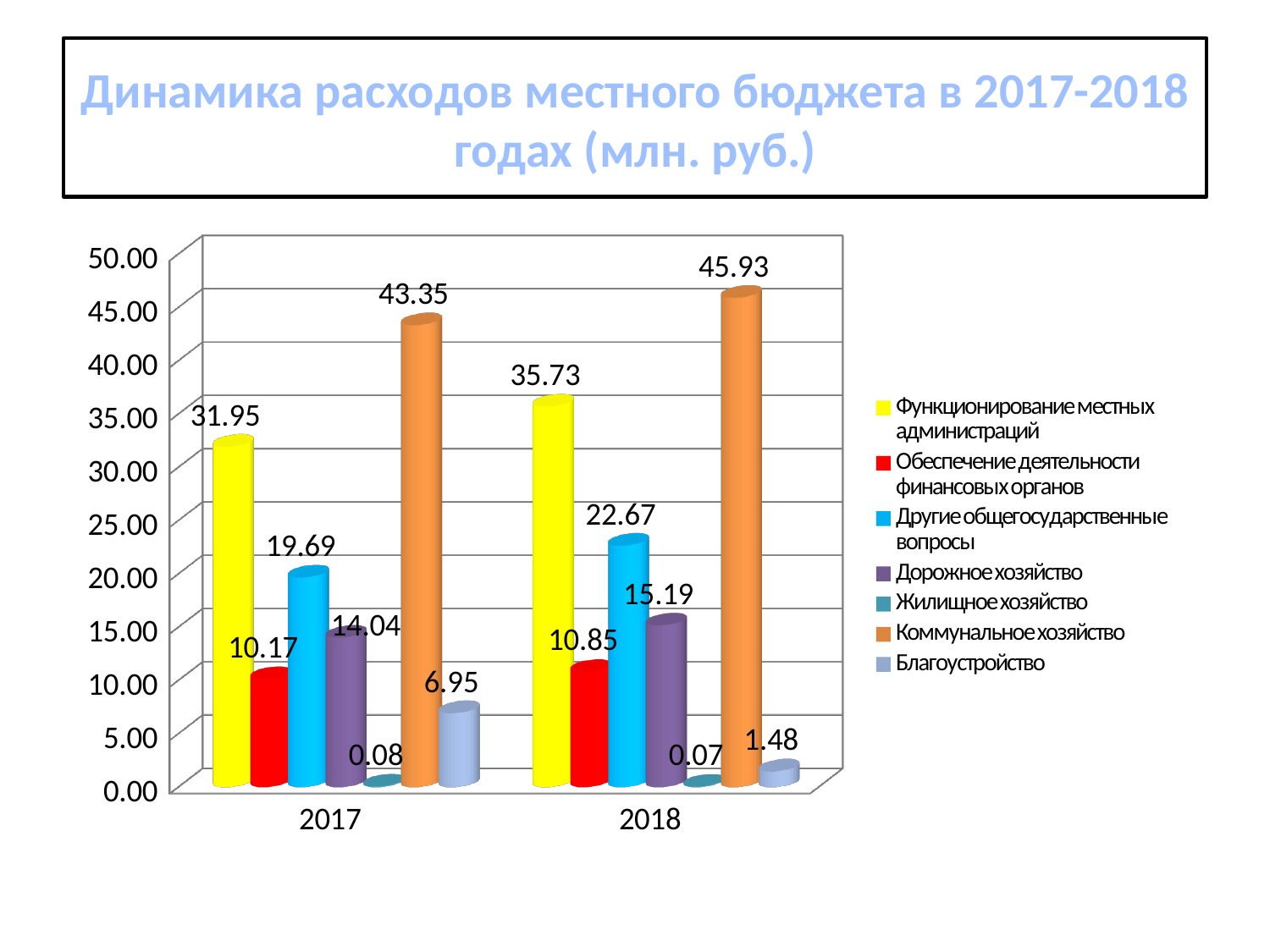
What is the value for Благоустройство in 2018? 1.48 Does the value for Функционирование местных администраций rise or fall from 2017 to 2018? rise Which series has the lowest value in 2018? Жилищное хозяйство What is the value for Жилищное хозяйство in 2017? 0.08 How many series does the legend list? 7 What is the difference between the Коммунальное хозяйство values for 2018 and 2017? 2.58 Which is larger: Другие общегосударственные вопросы in 2018 or Дорожное хозяйство in 2018? Другие общегосударственные вопросы in 2018 What is the value for Коммунальное хозяйство in 2018? 45.93 How many year categories are shown on the x axis? 2 Which series has the highest value in 2017? Коммунальное хозяйство What is the difference between the Благоустройство values for 2017 and 2018? 5.47 What is the value for Функционирование местных администраций in 2017? 31.95